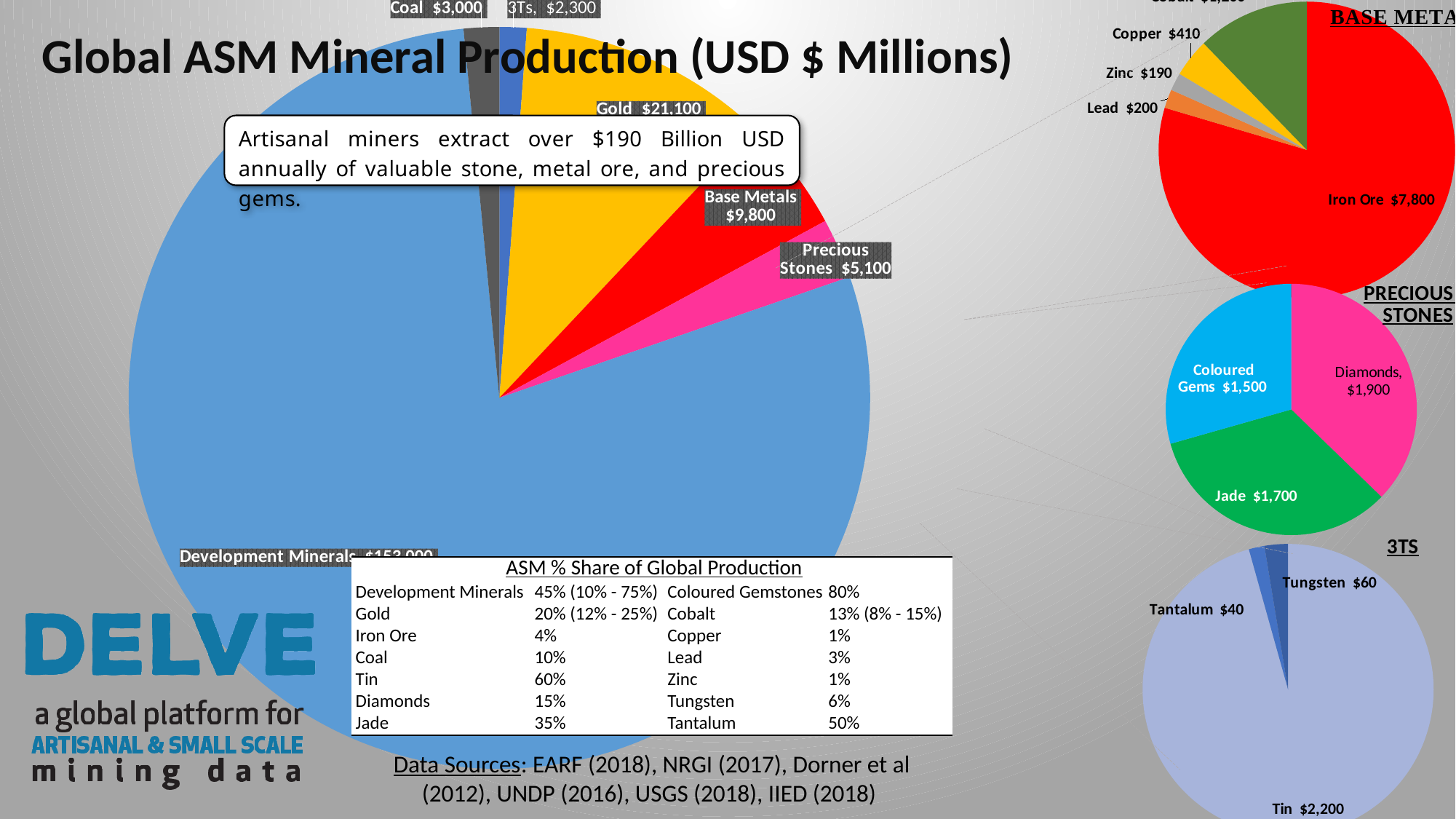
In the Base Metals pie chart, which is larger, Copper or Lead? Copper In the Global ASM Mineral Production pie chart, what is the value for Base Metals? $9,800 In the Precious Stones pie chart, which category has the largest value? Diamonds In the Base Metals pie chart, what is the value for Iron Ore? $7,800 What kind of chart is the Global ASM Mineral Production chart? Pie chart In the Global ASM Mineral Production pie chart, which category has the largest slice? Development Minerals In the 3Ts pie chart, which category has the smallest value? Tantalum In the Global ASM Mineral Production pie chart, what is the value for Coal? $3,000 In the Global ASM Mineral Production pie chart, what is the value for Gold? $21,100 In the Global ASM Mineral Production pie chart, what is the difference between the Gold and Base Metals values? $11,300 In the 3Ts pie chart, what is the value for Tin? $2,200 How many slices does the Precious Stones pie chart have? 3